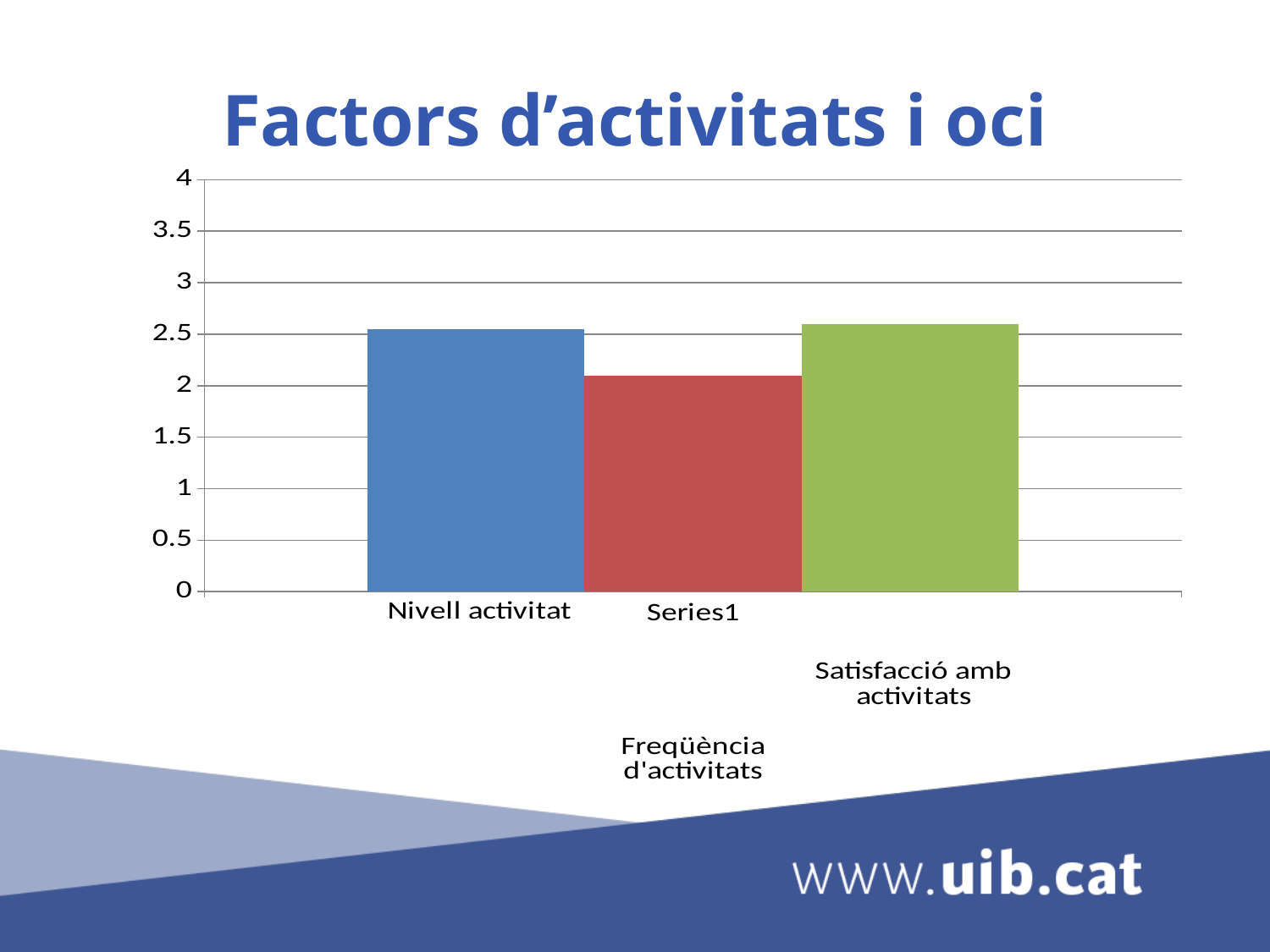
How many bars are plotted in the chart? 3 Is the value for Freqüència d'activitats greater or less than 2.5? less Is the value for Satisfacció amb activitats greater or less than 3? less Is the value for Satisfacció amb activitats greater or less than 2? greater What kind of chart is shown on the slide? bar chart Which is larger, the value for Nivell activitat or the value for Freqüència d'activitats? Nivell activitat What colour is the bar for Freqüència d'activitats? red Which category has the lowest value in the chart? Freqüència d'activitats What is the title of the chart on the slide? Factors d'activitats i oci Which is larger, the value for Satisfacció amb activitats or the value for Freqüència d'activitats? Satisfacció amb activitats